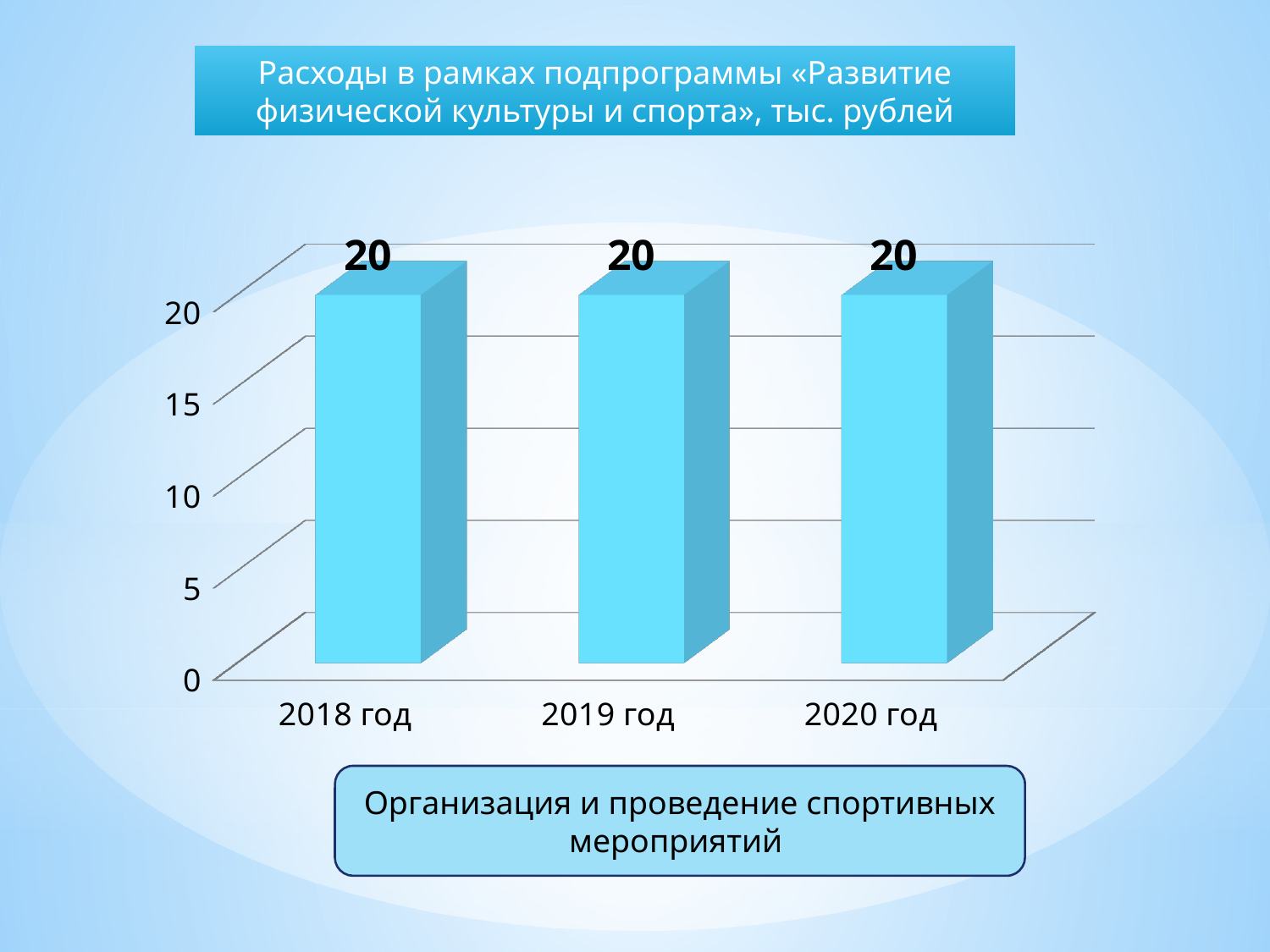
What is the title of the chart? Расходы в рамках подпрограммы «Развитие физической культуры и спорта», тыс. рублей Do the values rise, fall or stay the same from 2018 год to 2020 год? stay the same What is the value for 2020 год? 20 What is the total of the values for all three years? 60 What kind of chart is shown on the slide? bar chart What label appears in the box below the chart? Организация и проведение спортивных мероприятий What is the difference between the values for 2018 год and 2020 год? 0 How many categories are shown on the x axis? 3 What is the value for 2018 год? 20 What is the value for 2019 год? 20 Is the value for 2019 год greater or less than 10? greater